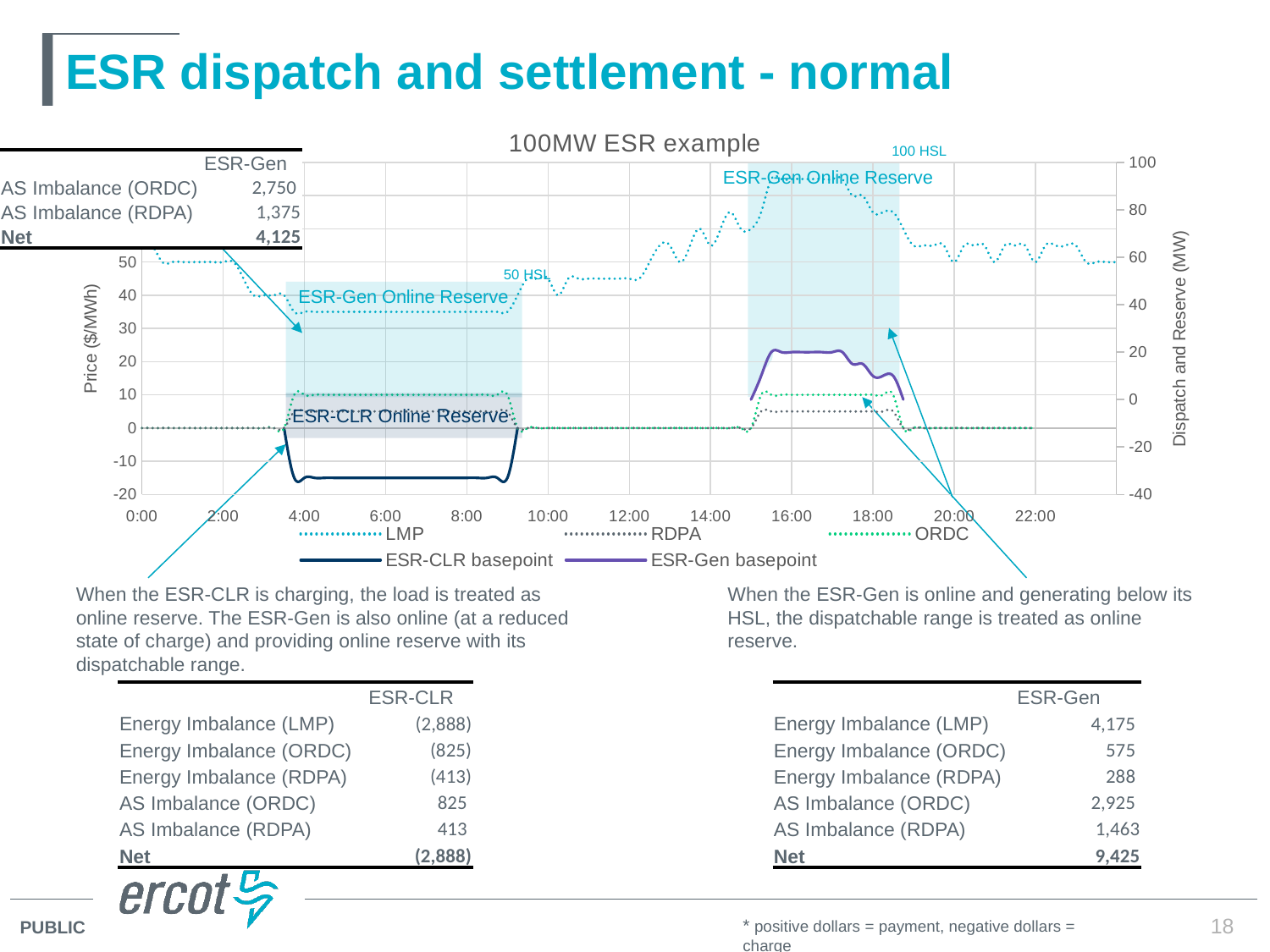
Is the ESR-Gen basepoint at 16:00 greater or less than 0? greater Is the LMP value at 12:00 greater or less than 40? greater Which is larger, the ESR-Gen basepoint at 16:00 or the ESR-CLR basepoint at 6:00? ESR-Gen basepoint at 16:00 Which series reaches the lowest value on the chart? ESR-CLR basepoint Is the LMP value at 16:00 greater or less than 60? greater What is the label of the left vertical axis of the chart? Price ($/MWh) What is the title of the chart? 100MW ESR example Which is larger, the LMP at 16:00 or the LMP at 6:00? LMP at 16:00 How many series does the chart legend list? 5 What type of chart is shown on the slide? line chart Does the LMP line rise or fall between 10:00 and 16:00? rise